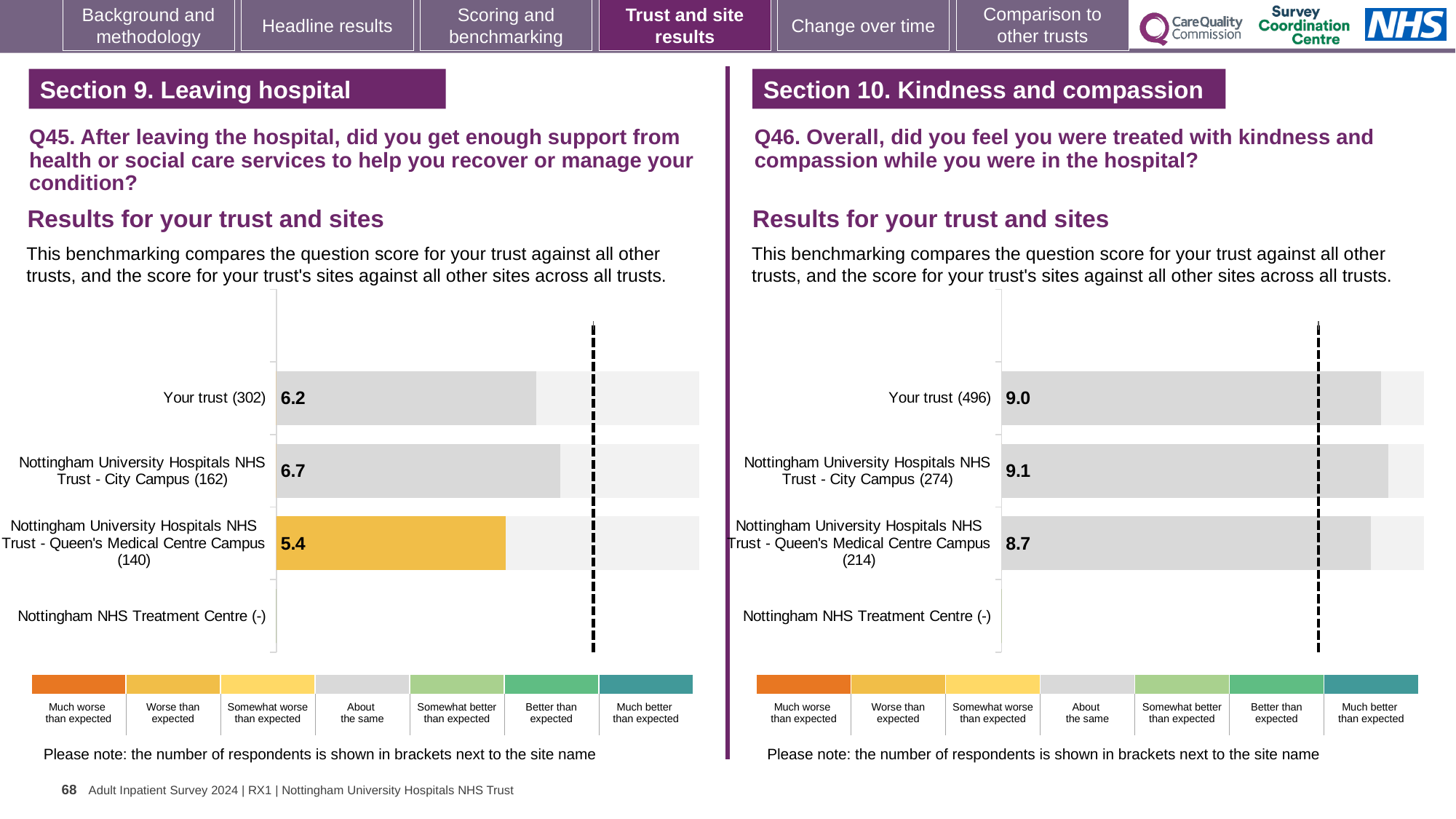
On the Q45 chart (left), what is the score for Nottingham University Hospitals NHS Trust - Queen's Medical Centre Campus (140)? 5.4 On the Q46 chart (right), what is the difference between the City Campus score and the Queen's Medical Centre Campus score? 0.4 On the Q45 chart (left), which site or trust has the lowest score? Nottingham University Hospitals NHS Trust - Queen's Medical Centre Campus (140) What type of chart is used on the Q46 chart (right)? Bar chart On the Q46 chart (right), which site or trust has the highest score? Nottingham University Hospitals NHS Trust - City Campus (274) On the Q45 chart (left), what is the score for Your trust (302)? 6.2 On the Q46 chart (right), what is the score for Nottingham University Hospitals NHS Trust - City Campus (274)? 9.1 On the Q45 chart (left), which bar is coloured orange/yellow rather than grey? Nottingham University Hospitals NHS Trust - Queen's Medical Centre Campus (140) On the Q46 chart (right), what is the score for Your trust (496)? 9.0 On the Q45 chart (left), which has the higher score: Your trust (302) or City Campus (162)? City Campus (162) On the Q45 chart (left), what is the difference between the City Campus score and the Queen's Medical Centre Campus score? 1.3 On the Q45 chart (left), how many sites or trusts are listed on the vertical axis? 4